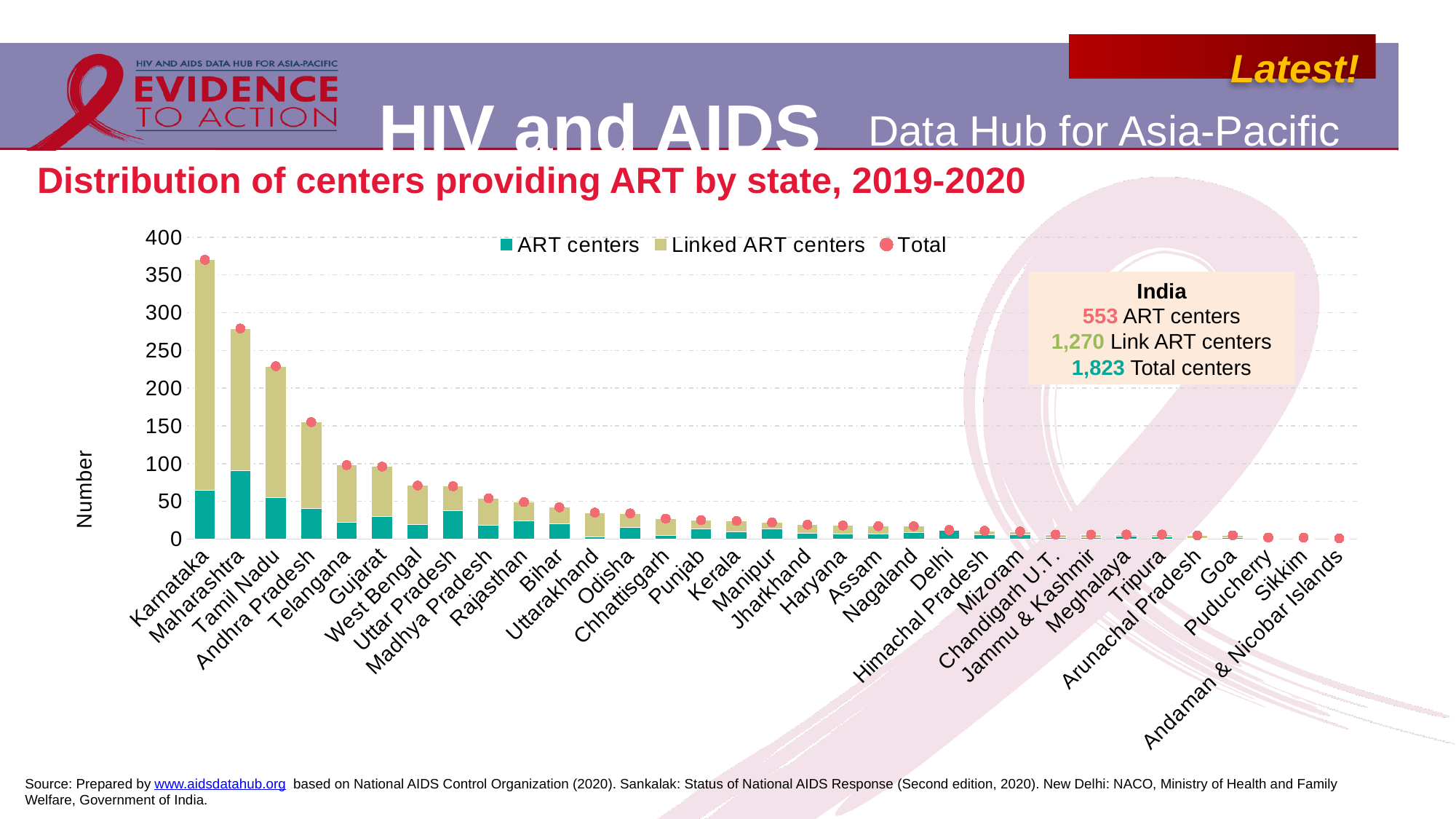
Which has a larger total, Maharashtra or Tamil Nadu? Maharashtra Which state has the highest number of ART centers (the teal series)? Maharashtra Is the total value for Maharashtra greater or less than 250? greater How many series does the legend list? 3 How many states or territories are shown on the x axis? 33 Is the total value for Karnataka greater or less than 350? greater What kind of chart is shown on the slide? bar chart Do the total values rise or fall moving from left to right along the x axis? fall According to the text box on the slide, how many total centers does India have? 1,823 Is the total value for Tamil Nadu greater or less than 200? greater Which state has the highest total number of centers providing ART? Karnataka